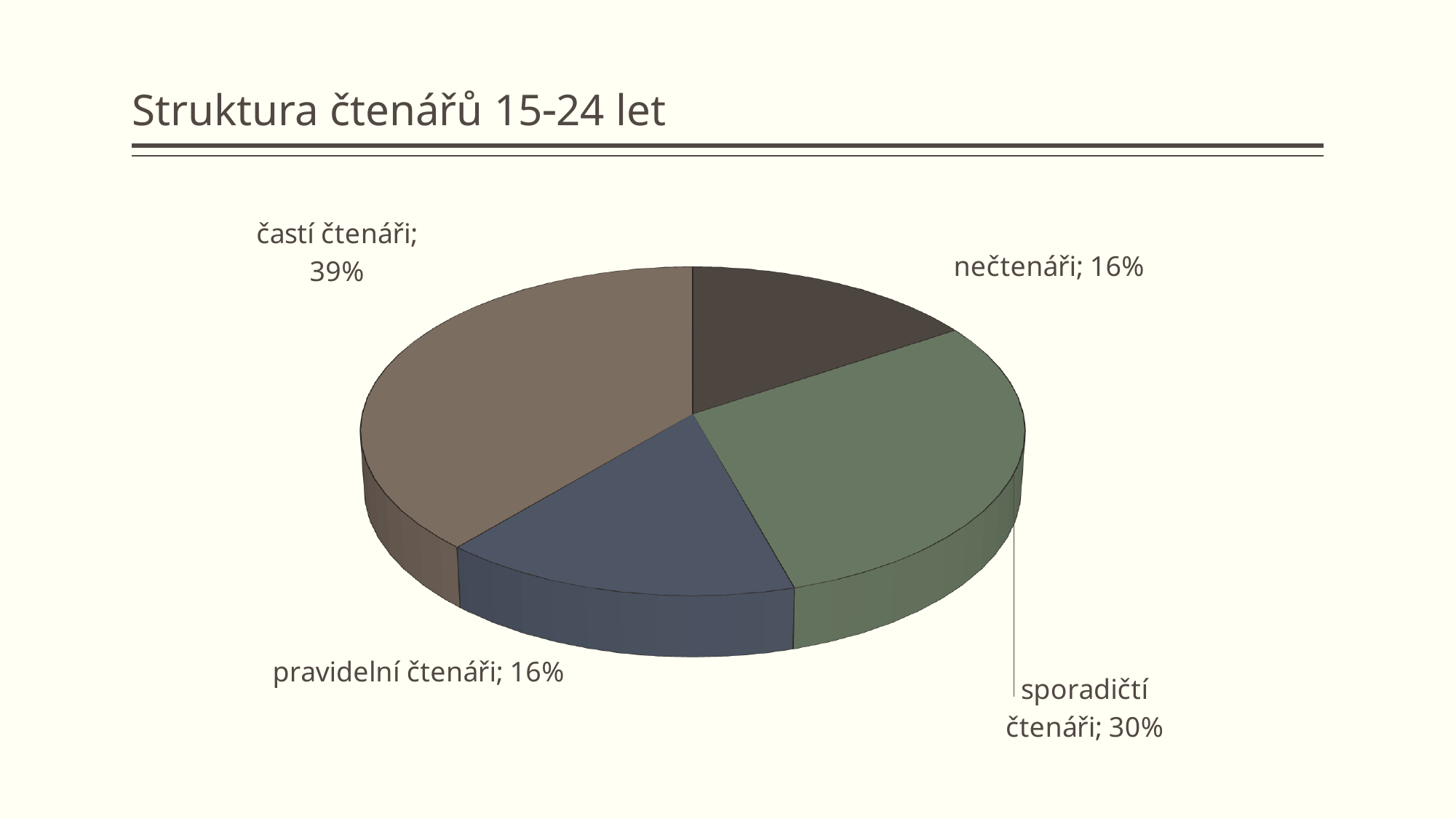
What share of the pie is labelled 'sporadičtí čtenáři'? 30% Which is larger, the slice for 'sporadičtí čtenáři' or the slice for 'pravidelní čtenáři'? sporadičtí čtenáři What kind of chart is shown on the slide? pie chart What share of the pie is labelled 'častí čtenáři'? 39% What share of the pie is labelled 'nečtenáři'? 16% Which category has the largest slice of the pie? častí čtenáři Which two categories share the same percentage in the pie chart? nečtenáři and pravidelní čtenáři How many slices does the pie chart have? 4 What is the difference in percentage points between 'sporadičtí čtenáři' and 'nečtenáři'? 14 What is the difference in percentage points between 'častí čtenáři' and 'sporadičtí čtenáři'? 9 What is the title of the slide containing the chart? Struktura čtenářů 15-24 let